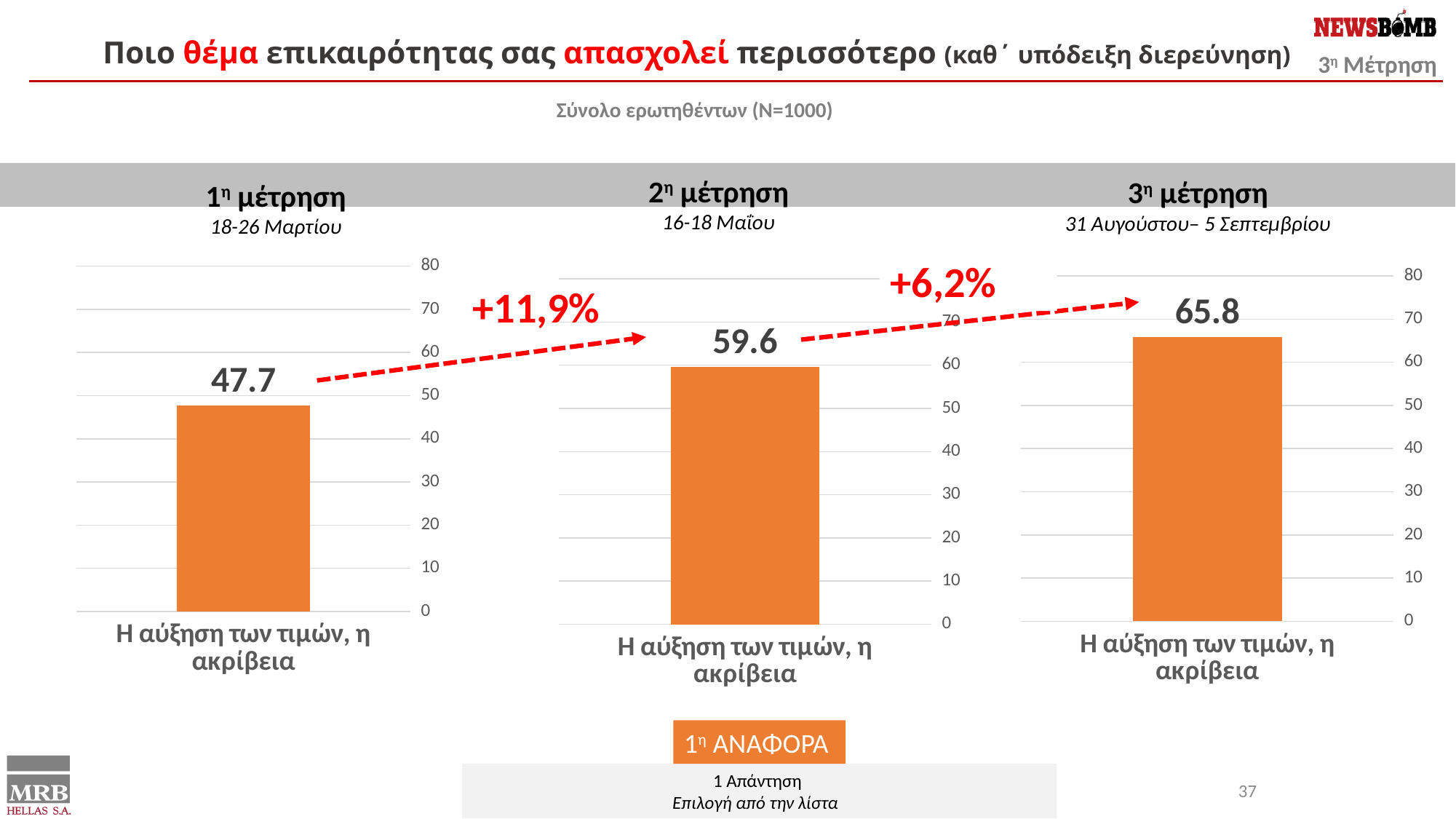
Which is larger: the value in the middle chart (2η μέτρηση) or the value in the right chart (3η μέτρηση)? 3η μέτρηση What is the difference between the value in the middle chart (2η μέτρηση) and the value in the left chart (1η μέτρηση)? 11.9 What kind of chart is used in each of the three panels on the slide? Bar chart In the right chart (3η μέτρηση, 31 Αυγούστου – 5 Σεπτεμβρίου), what is the value for 'Η αύξηση των τιμών, η ακρίβεια'? 65.8 In the middle chart (2η μέτρηση, 16-18 Μαΐου), what is the value for 'Η αύξηση των τιμών, η ακρίβεια'? 59.6 What is the difference between the value in the right chart (3η μέτρηση) and the value in the left chart (1η μέτρηση)? 18.1 What percentage change is written on the red arrow between the 2η μέτρηση chart and the 3η μέτρηση chart? +6,2% Across the three charts, which measurement (μέτρηση) shows the highest value for 'Η αύξηση των τιμών, η ακρίβεια'? 3η μέτρηση In the left chart (1η μέτρηση, 18-26 Μαρτίου), what is the value for 'Η αύξηση των τιμών, η ακρίβεια'? 47.7 Reading from the left chart to the right chart, do the values for 'Η αύξηση των τιμών, η ακρίβεια' rise or fall? Rise In the left chart (1η μέτρηση), is the value for 'Η αύξηση των τιμών, η ακρίβεια' greater or less than 50? less Across the three charts, which measurement (μέτρηση) shows the lowest value for 'Η αύξηση των τιμών, η ακρίβεια'? 1η μέτρηση